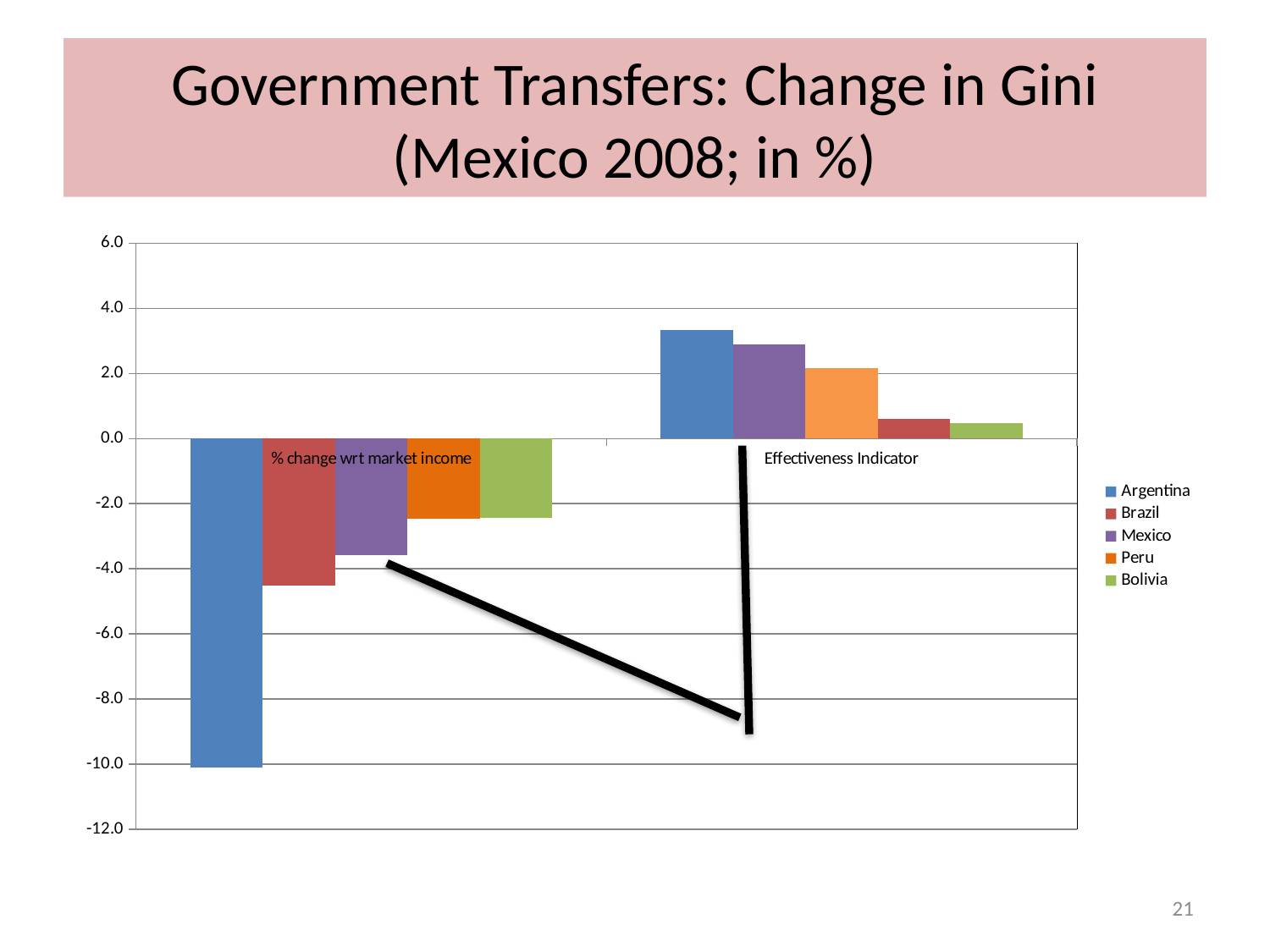
Is the value for Mexico under '% change wrt market income' greater or less than -4.0? greater How many series does the legend list? 5 Under '% change wrt market income', which is lower, Brazil or Mexico? Brazil Which country has the lowest value for '% change wrt market income'? Argentina Is the value for Brazil under 'Effectiveness Indicator' greater or less than 2.0? less Is the value for Argentina under '% change wrt market income' greater or less than -8.0? less How many categories are shown on the x axis? 2 Which country has the highest value for 'Effectiveness Indicator'? Argentina Which colour represents Bolivia in the legend? green What kind of chart is shown on the slide? bar chart